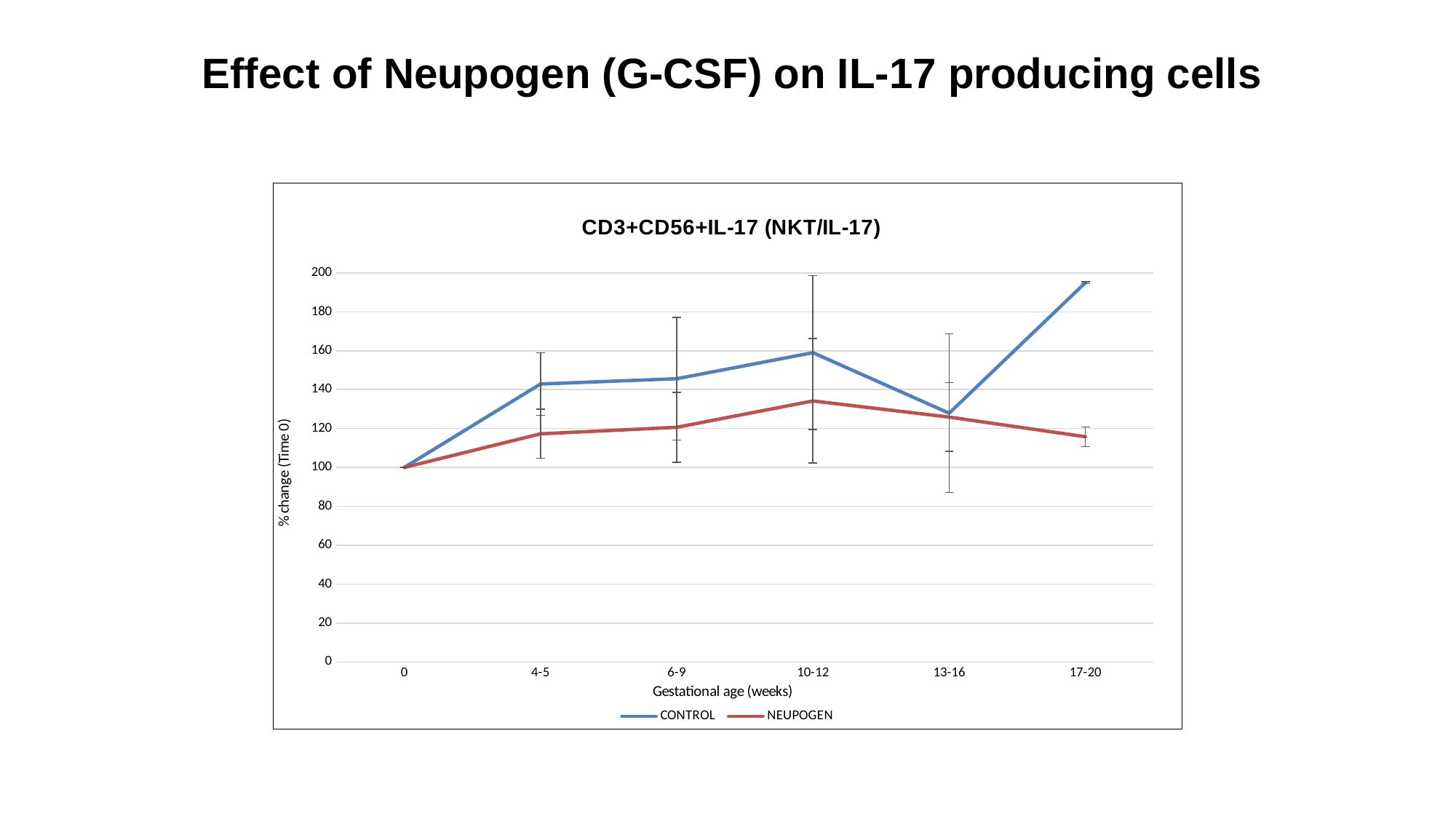
At 10-12 weeks, which series has the larger value, CONTROL or NEUPOGEN? CONTROL Is the value for CONTROL at 17-20 weeks greater or less than 180? greater What kind of chart is shown on the slide? line chart What is the value for CONTROL at gestational age 0? 100 Is the value for NEUPOGEN at 17-20 weeks greater or less than 140? less At which gestational age is the NEUPOGEN series highest? 10-12 How many gestational age categories are plotted on the x axis? 6 Does the NEUPOGEN series rise or fall from 10-12 weeks to 17-20 weeks? fall What is the title of the chart? CD3+CD56+IL-17 (NKT/IL-17) How many series does the legend list? 2 At which gestational age is the CONTROL series highest? 17-20 What is the value for NEUPOGEN at gestational age 0? 100